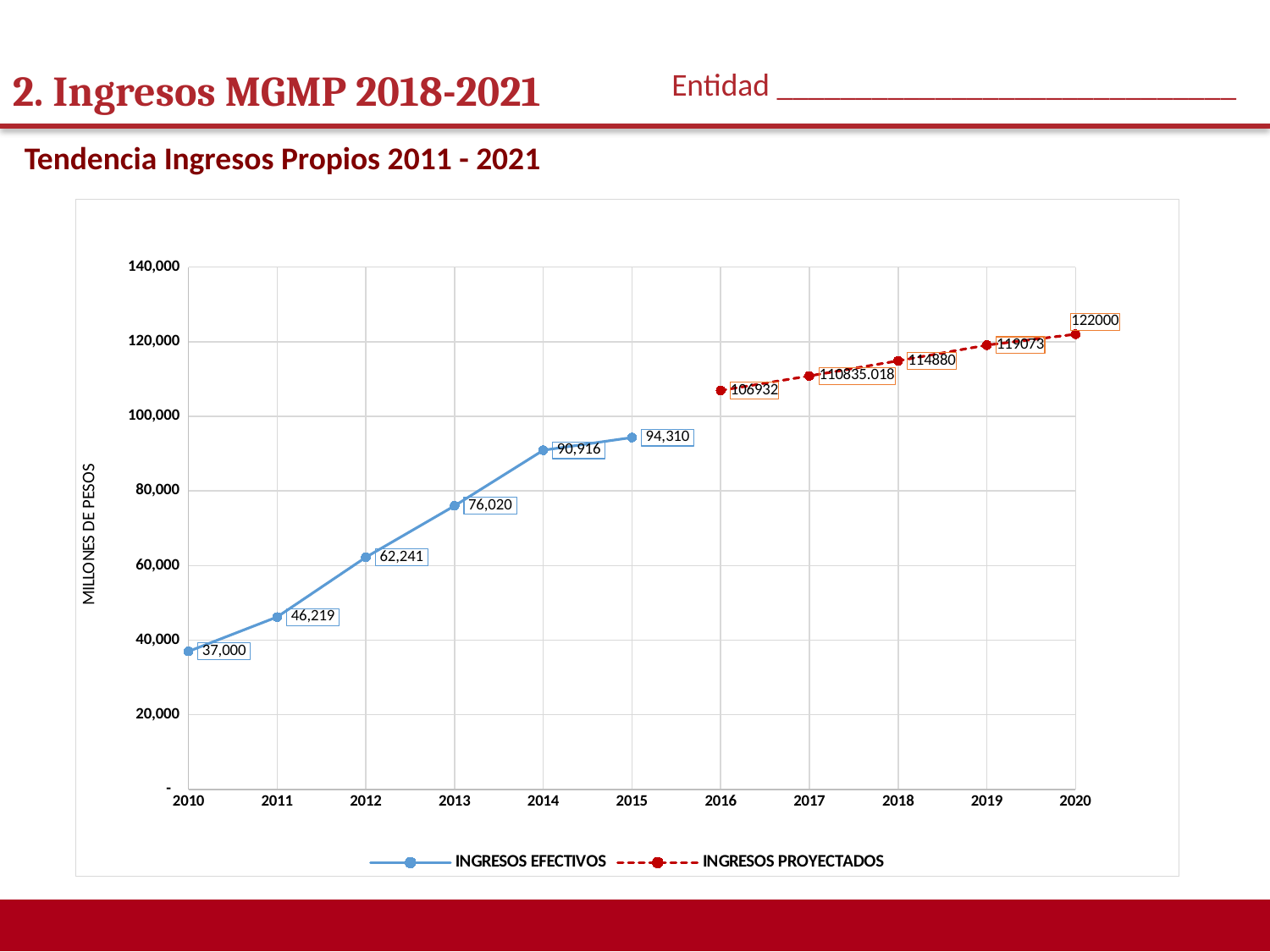
What is the value of INGRESOS PROYECTADOS for 2020? 122000 Which year has the highest value for INGRESOS PROYECTADOS? 2020 What is the label of the vertical axis? MILLONES DE PESOS What is the difference between the INGRESOS EFECTIVOS values for 2015 and 2014? 3,394 What is the value of INGRESOS EFECTIVOS for 2010? 37,000 How many series does the legend list? 2 Do the INGRESOS EFECTIVOS values rise or fall from 2010 to 2015? rise What type of chart is shown on the slide? line chart Which year has the lowest value for INGRESOS EFECTIVOS? 2010 Which is larger, the INGRESOS EFECTIVOS value for 2012 or for 2011? 2012 What is the value of INGRESOS EFECTIVOS for 2013? 76,020 What is the value of INGRESOS PROYECTADOS for 2017? 110835.018